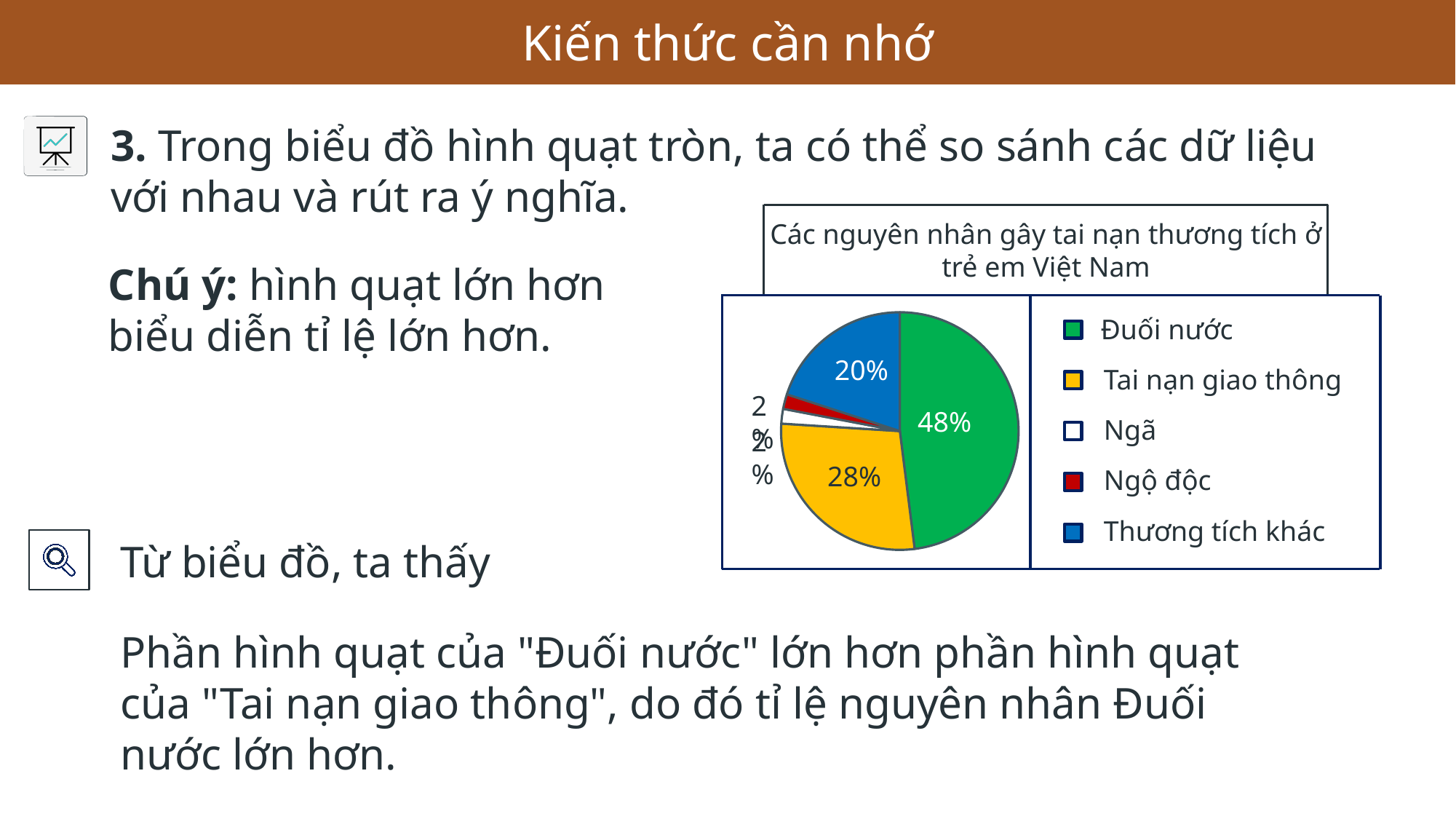
How many categories are shown in the pie chart? 5 Which is larger, the slice for "Tai nạn giao thông" or the slice for "Thương tích khác"? Tai nạn giao thông What is the difference in percentage points between "Đuối nước" and "Tai nạn giao thông"? 20 Which colour represents "Ngộ độc" in the chart? Red How many entries does the legend list? 5 What is the value shown for "Thương tích khác"? 20% What type of chart is shown on the slide? Pie chart What is the title of the chart? Các nguyên nhân gây tai nạn thương tích ở trẻ em Việt Nam What percentage does the "Tai nạn giao thông" slice show? 28% What percentage of the pie chart is represented by "Đuối nước"? 48% Which category has the largest slice of the pie chart? Đuối nước What is the difference in percentage points between "Đuối nước" and "Thương tích khác"? 28